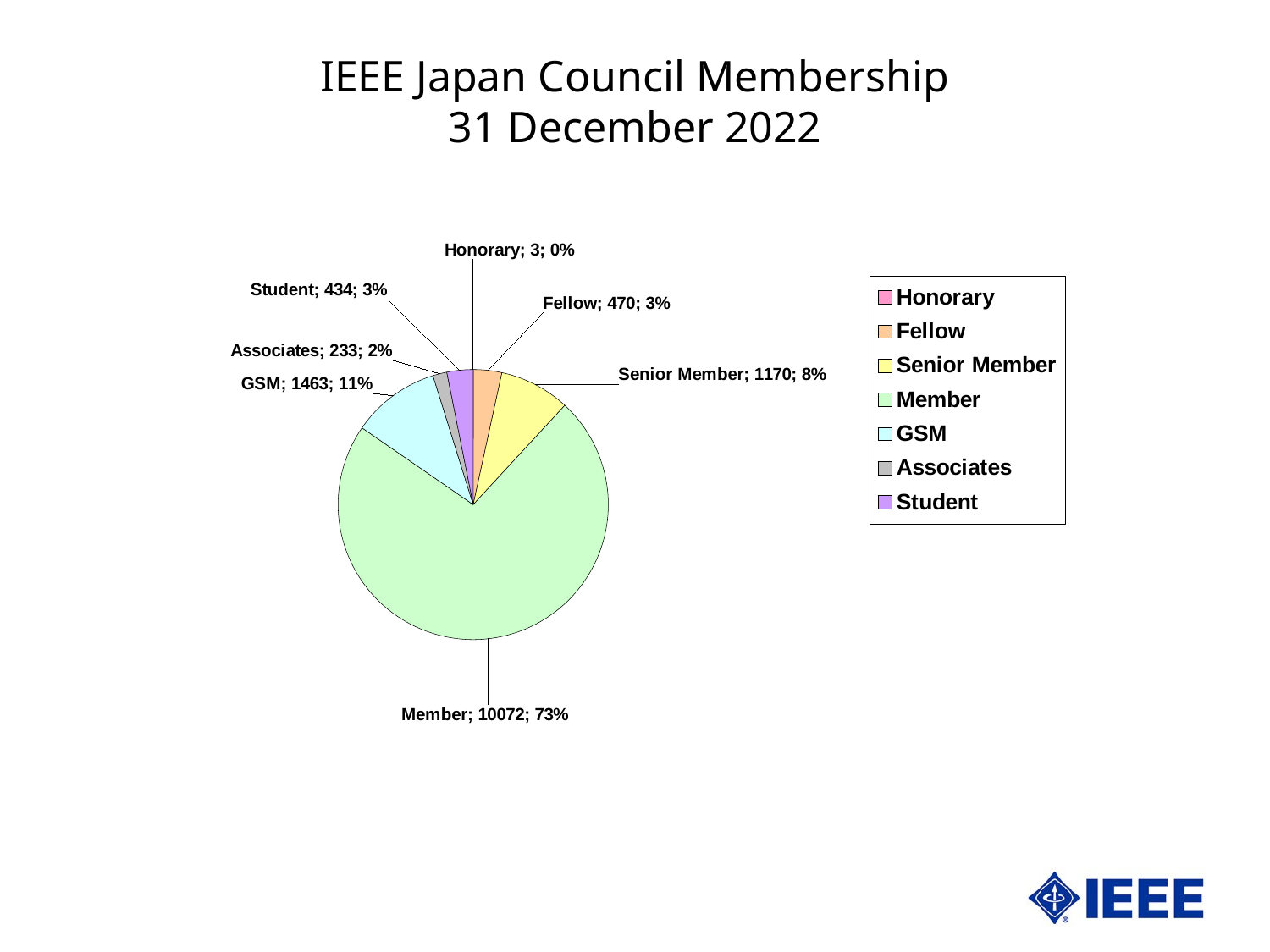
Which category has the largest slice of the pie? Member What share of the pie does GSM represent? 11% What is the value for Associates? 233 Which category has the smallest slice of the pie? Honorary How many members are in the Member category? 10072 What is the value for GSM? 1463 Which is larger, Senior Member or GSM? GSM What is the value for Senior Member? 1170 What kind of chart is shown on the slide? pie chart What share of the pie does Member represent? 73% What is the difference between the Fellow and Student values? 36 How many categories does the legend list? 7